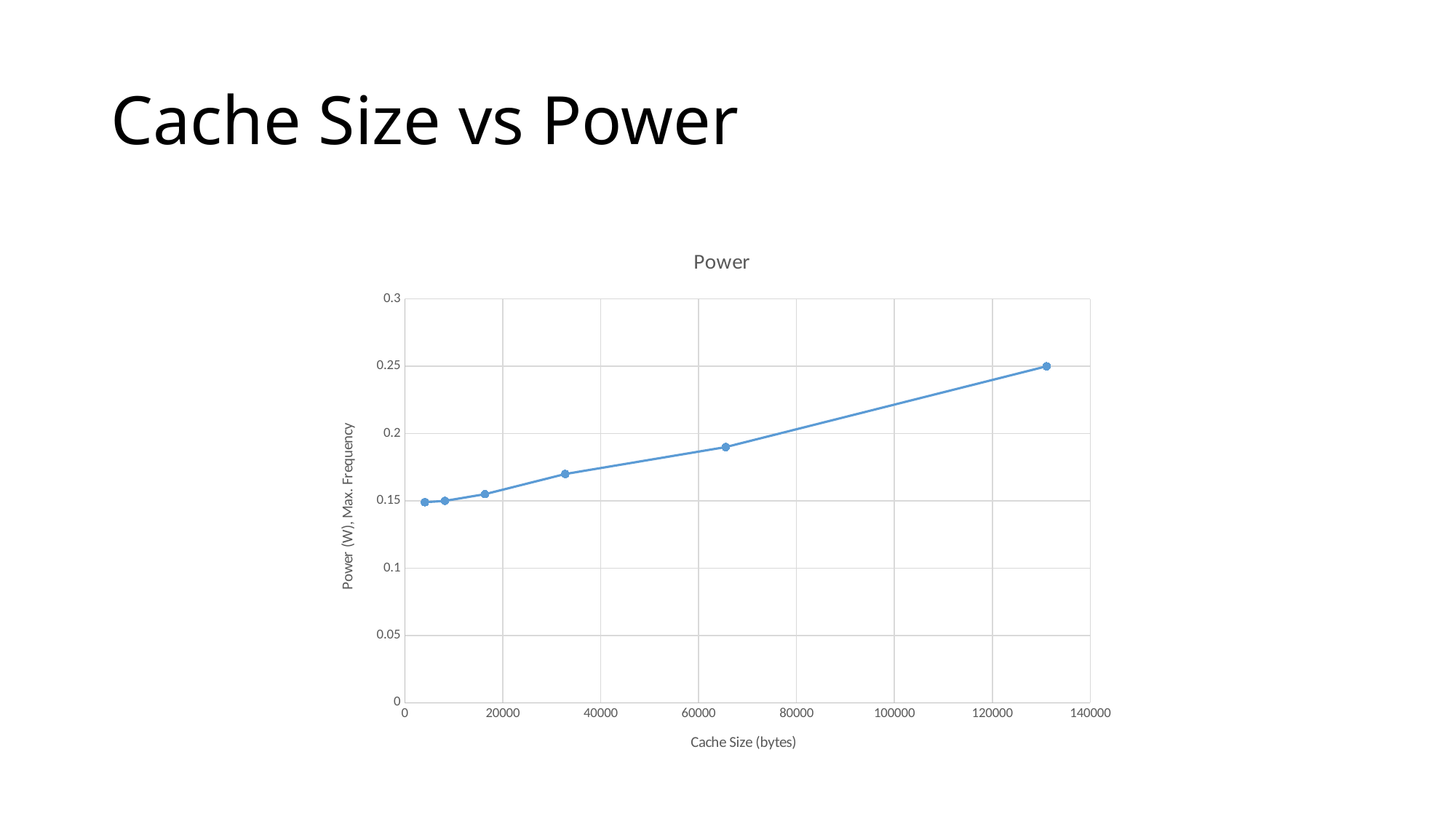
What is the title of the chart? Power Is the power value at the largest cache size (about 131000 bytes) greater or less than 0.2? greater Is the power at a cache size of about 65000 bytes larger or smaller than the power at about 33000 bytes? larger Does power rise or fall as cache size increases along the x axis? rise Is the power value at a cache size of about 33000 bytes greater or less than 0.15? greater Is the power value at the largest cache size greater or less than 0.3? less What is the label of the x axis? Cache Size (bytes) What kind of chart is shown on the slide? line chart How many data points are plotted on the Power chart? 6 Which data point has the highest power value: the one at the smallest cache size or the one at the largest cache size? the one at the largest cache size